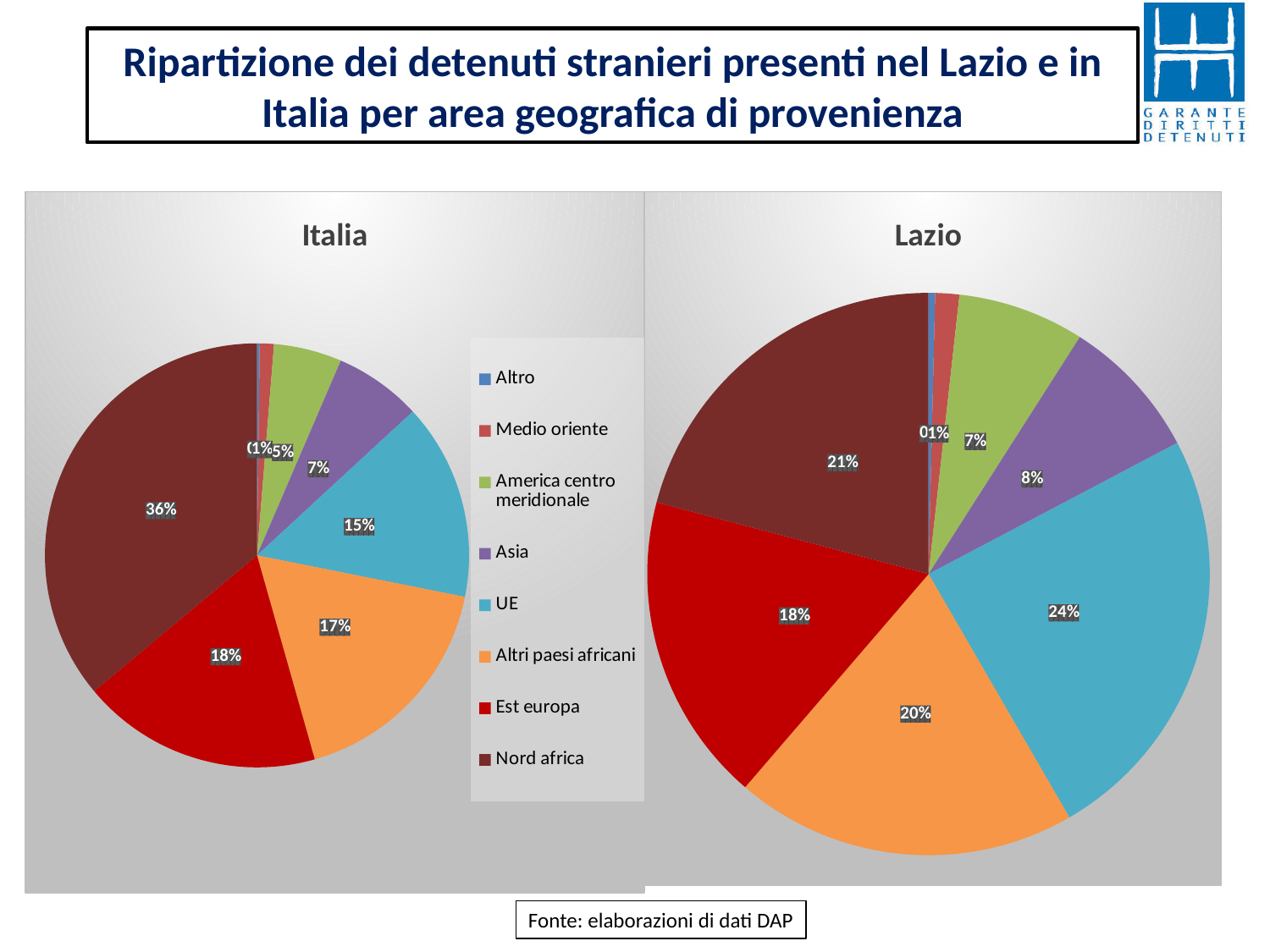
How many entries does the legend list? 8 In the Italia pie chart, what share is Nord africa? 36% In the Italia pie chart, which area has the largest share? Nord africa In the Italia pie chart, what share is Asia? 7% What type of chart is used for Italia and Lazio? Pie chart In the Italia pie chart, what share is Altri paesi africani? 17% What is the difference between the Nord africa share in the Italia chart and the Nord africa share in the Lazio chart? 15% In the Lazio pie chart, what share is Nord africa? 21% What colour represents Est europa in the legend? Red